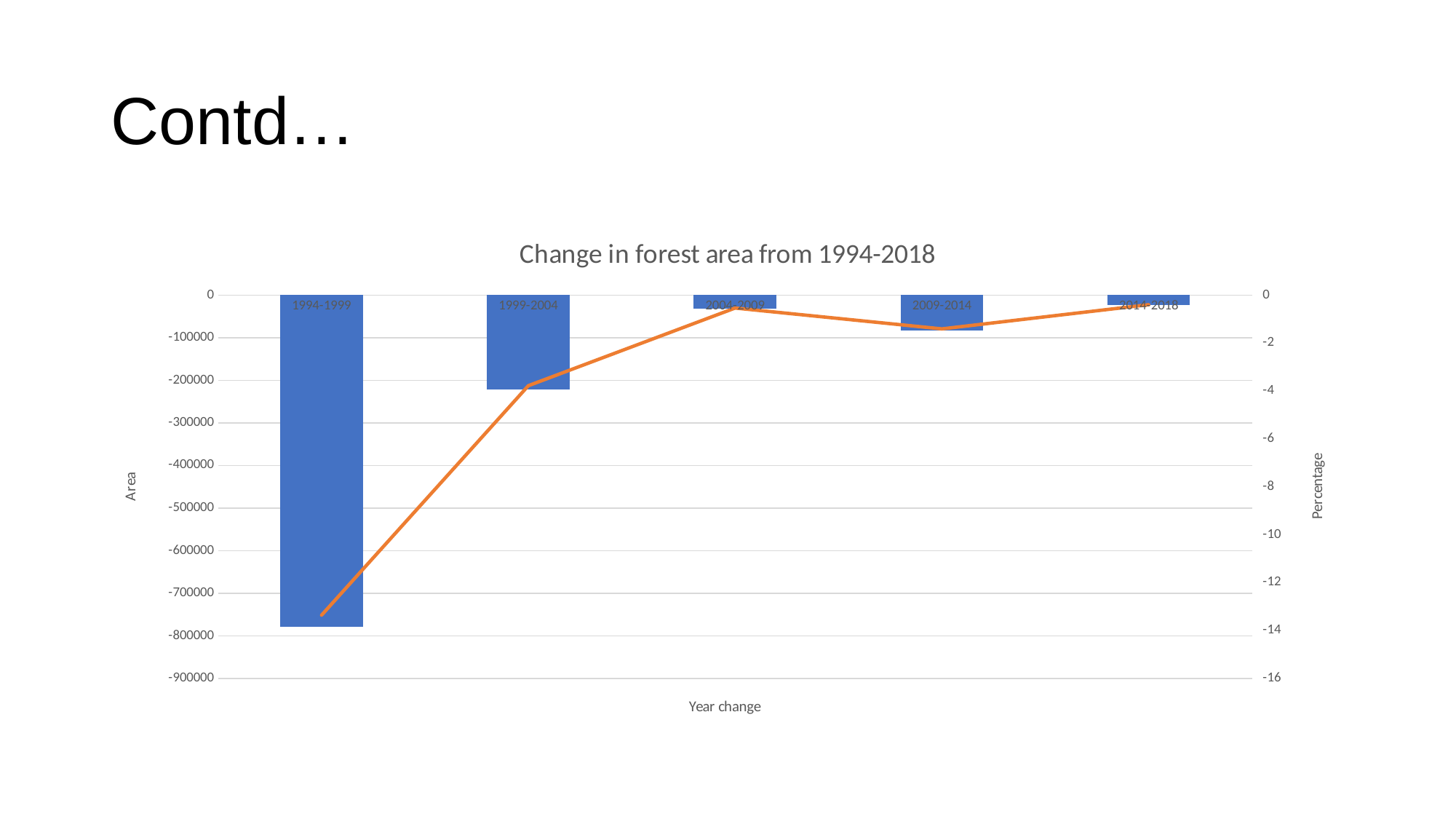
Is the area value for 1999-2004 greater or less than -300000? greater What kind of chart is shown on the slide? A combined bar and line chart From 1994-1999 to 2004-2009, do the bar values rise or fall? rise What is the label of the left vertical axis? Area How many year-change categories are plotted on the x axis? 5 Which category has the lowest (most negative) area value? 1994-1999 What is the title of the chart? Change in forest area from 1994-2018 Is the percentage value of the line for 2004-2009 greater or less than -2? greater Is the percentage value of the line for 1994-1999 greater or less than -12? less Which bar extends further below zero, 1999-2004 or 2009-2014? 1999-2004